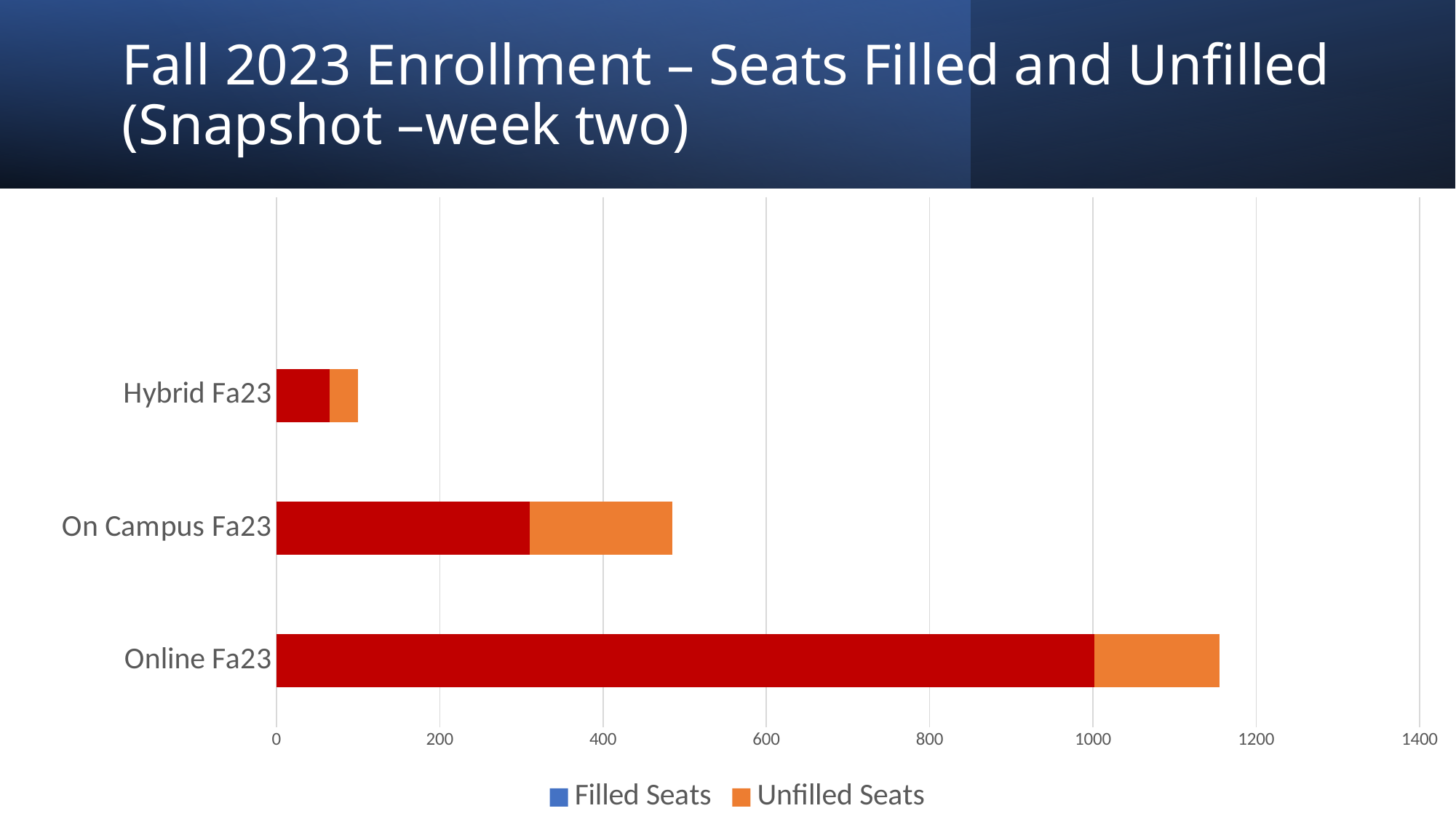
How many categories are plotted on the chart? 3 Is the total bar length for Online Fa23 greater or less than 1000? greater Which category has the shortest total bar? Hybrid Fa23 How many series does the legend list? 2 Which has more Filled Seats, Online Fa23 or On Campus Fa23? Online Fa23 Is the Filled Seats value for On Campus Fa23 greater or less than 200? greater What kind of chart is shown on the slide? bar chart Is the total bar length for Hybrid Fa23 greater or less than 200? less Which category has the longest total bar? Online Fa23 What are the two series named in the legend? Filled Seats and Unfilled Seats